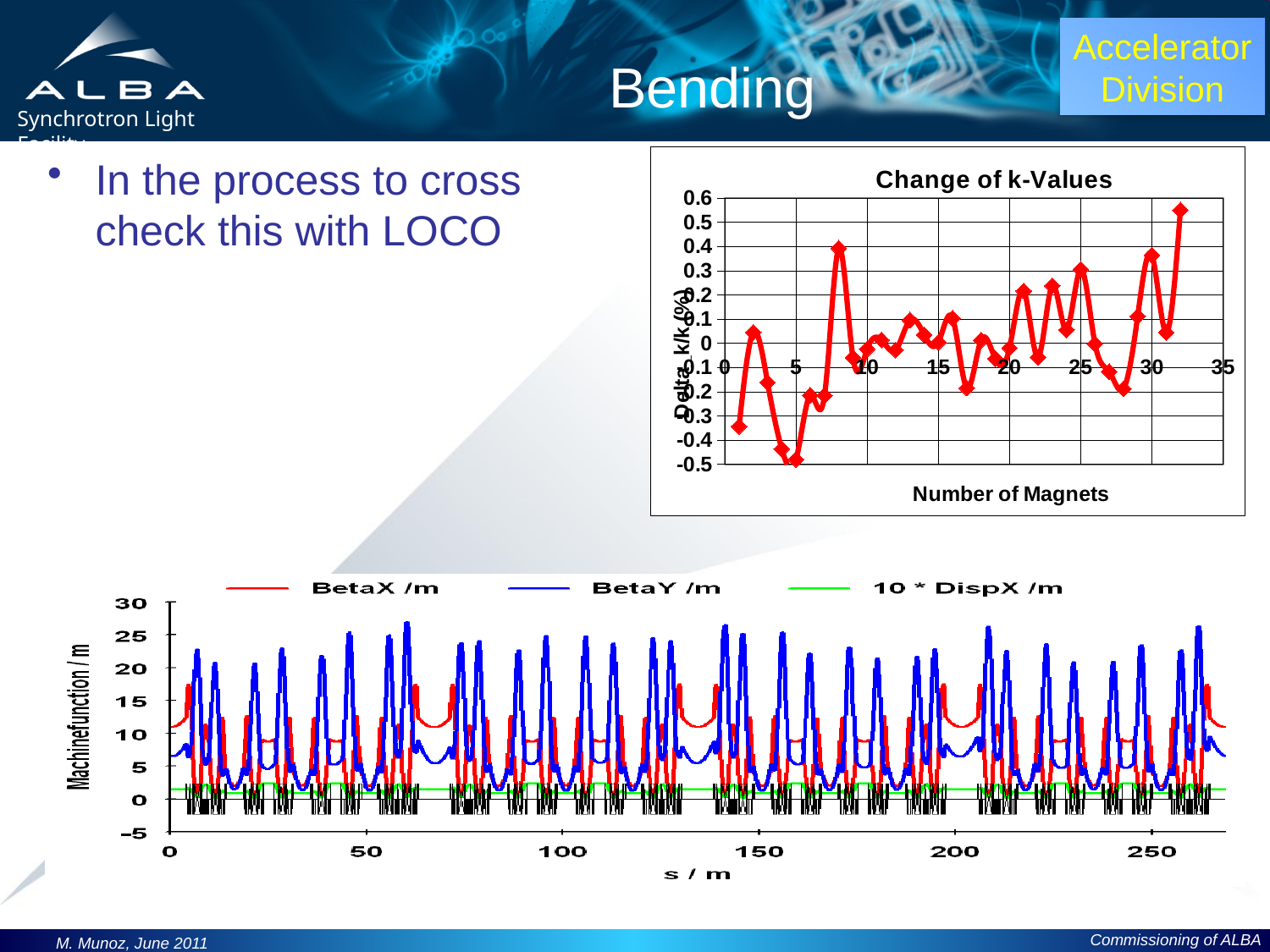
In the bottom chart, which series reaches the highest values, BetaX /m or BetaY /m? BetaY /m In the 'Change of k-Values' chart, what is the label of the x axis? Number of Magnets In the 'Change of k-Values' chart, is the highest point on the line at the beginning or at the end of the x axis? at the end In the 'Change of k-Values' chart, is the value for magnet number 5 greater or less than -0.3? less In the bottom chart, is the highest peak of BetaY /m greater or less than 25? greater In the 'Change of k-Values' chart, is the value for magnet number 8 greater or less than 0.2? greater What is the title of the chart in the upper right of the slide? Change of k-Values In the bottom chart, how many series does the legend list? 3 In the 'Change of k-Values' chart, what kind of chart is shown? line chart In the bottom chart, what kind of chart is shown? line chart